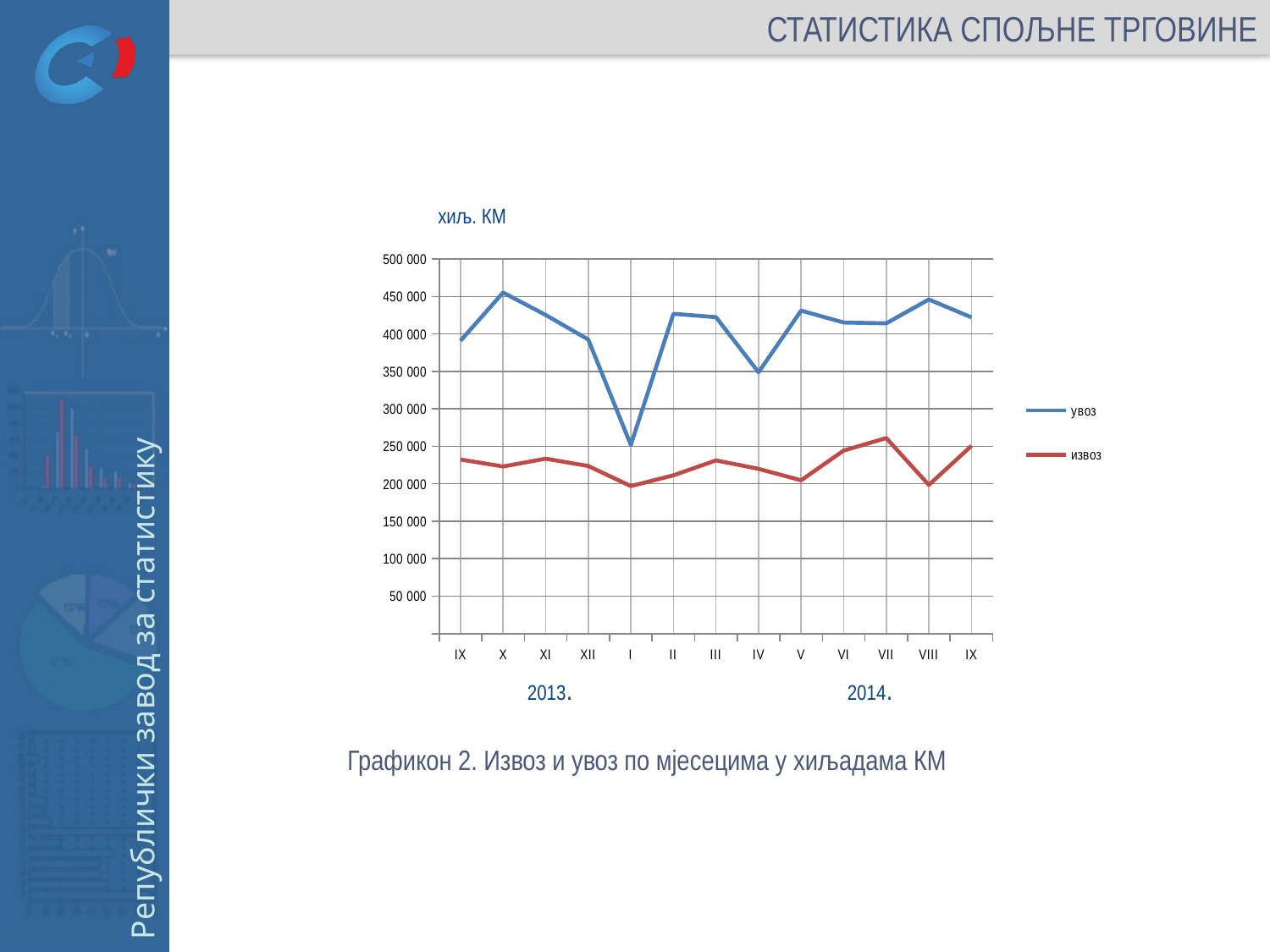
How many monthly points are plotted along the x axis? 13 Which series has the larger value in month V of 2014, увоз or извоз? увоз Does the увоз line rise or fall from month XII of 2013 to month I of 2014? fall In which month is the извоз line at its highest? VII (2014) How many series does the chart legend list? 2 What kind of chart is shown on the slide? line chart Is the value of извоз in month VII of 2014 greater or less than 250 000? greater In which month is the увоз line at its lowest? I (2014) Is the value of увоз in month I of 2014 greater or less than 300 000? less Is the value of увоз in month X of 2013 greater or less than 400 000? greater What are the two series named in the legend? увоз and извоз What unit label is shown above the vertical axis of the chart? хиљ. КМ